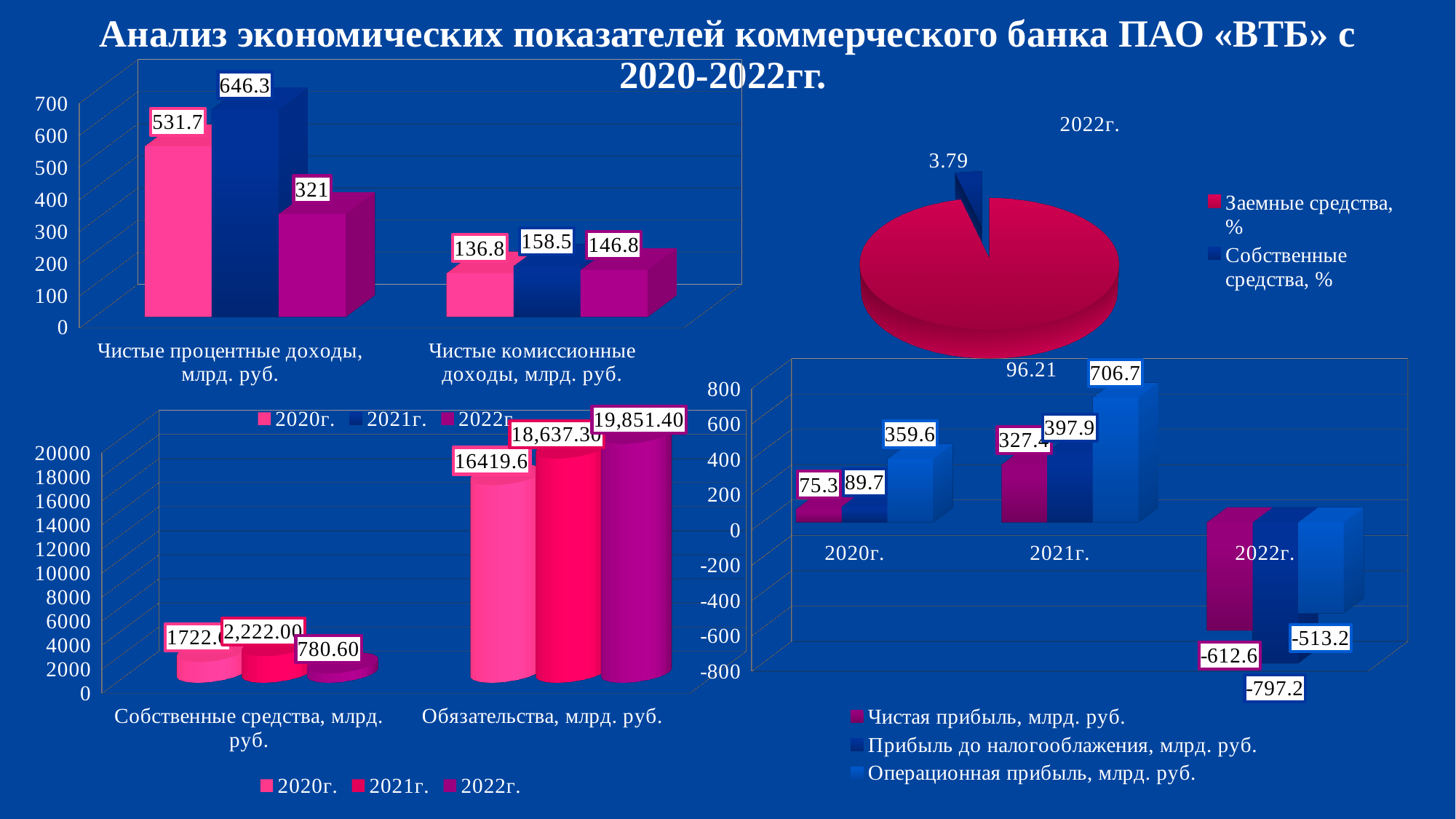
In the pie chart for 2022г., what value is shown for Собственные средства, %? 3.79 In the bottom-right bar chart, what is the value of Операционная прибыль, млрд. руб. for 2021г.? 706.7 In the top-left bar chart, what is the value of net commission income (Чистые комиссионные доходы) for 2022? 146.8 In the pie chart for 2022г., what share is shown for Заемные средства, %? 96.21 In the top-left bar chart, what is the difference between net interest income in 2021 and 2022? 325.3 In the top-left bar chart, which year has the highest net interest income? 2021г. In the top-left bar chart, what is the value of net interest income (Чистые процентные доходы) for 2021? 646.3 In the bottom-right bar chart, which is larger for 2022г.: Чистая прибыль or Прибыль до налогообложения? Чистая прибыль In the bottom-left bar chart, how many series does the legend list? 3 In the bottom-right bar chart, what is the value of Чистая прибыль, млрд. руб. for 2020г.? 75.3 In the bottom-left bar chart, what is the value of Собственные средства, млрд. руб. for 2022? 780.60 In the bottom-left bar chart, what is the value of Обязательства, млрд. руб. for 2022? 19,851.40